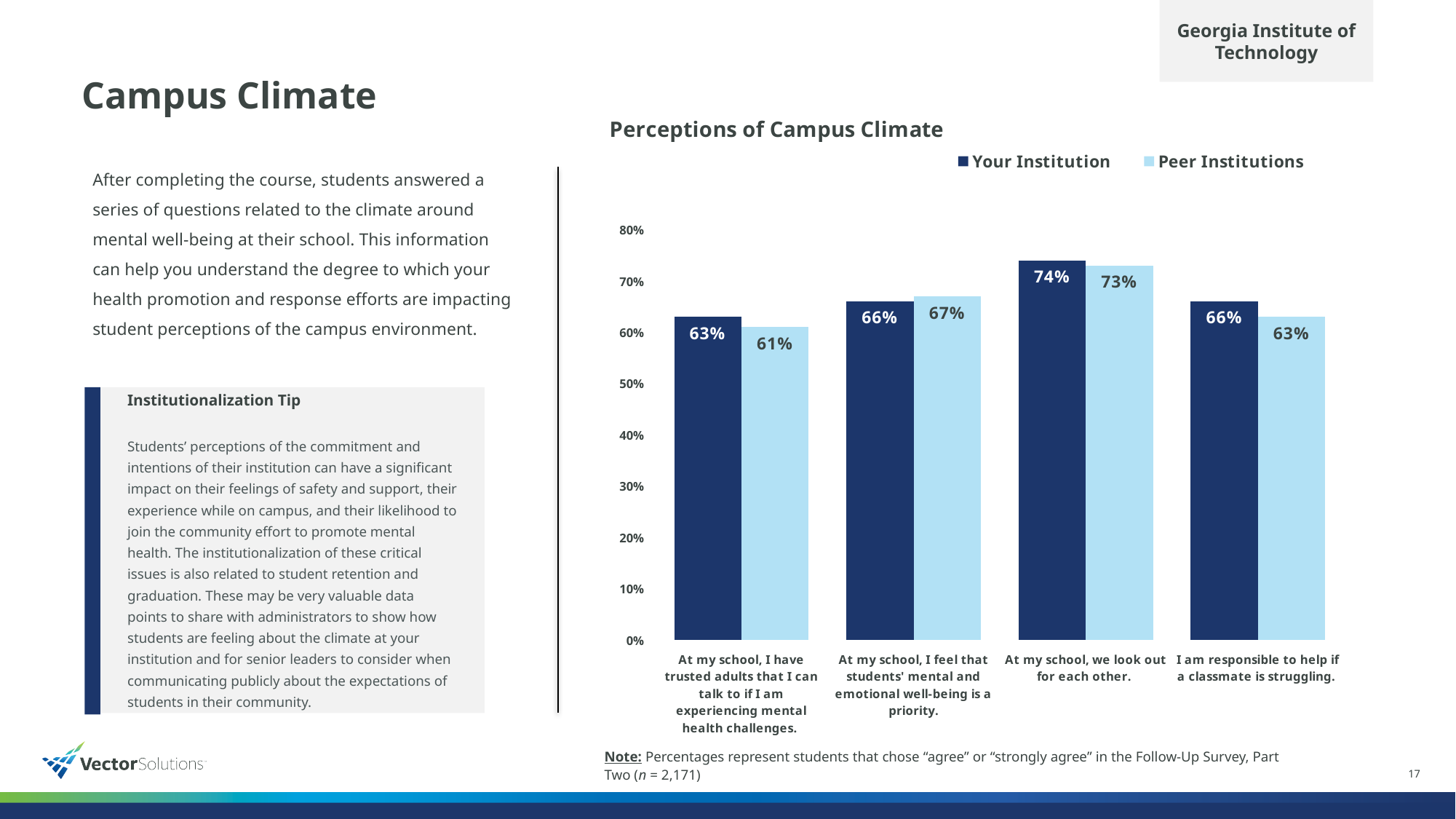
Which category has the highest Your Institution value? At my school, we look out for each other. What is the Your Institution value for "At my school, we look out for each other."? 74% What is the Peer Institutions value for "I am responsible to help if a classmate is struggling."? 63% What is the Peer Institutions value for "At my school, I have trusted adults that I can talk to if I am experiencing mental health challenges."? 61% How many categories are shown on the x axis? 4 How many series does the legend list? 2 Is the Your Institution value for "At my school, we look out for each other." greater or less than 70%? greater What is the title of the chart? Perceptions of Campus Climate What is the difference between the Your Institution and Peer Institutions values for "I am responsible to help if a classmate is struggling."? 3% For "At my school, I feel that students' mental and emotional well-being is a priority.", which is larger: Your Institution or Peer Institutions? Peer Institutions Which category has the lowest Peer Institutions value? At my school, I have trusted adults that I can talk to if I am experiencing mental health challenges. What kind of chart is shown on the slide? Bar chart